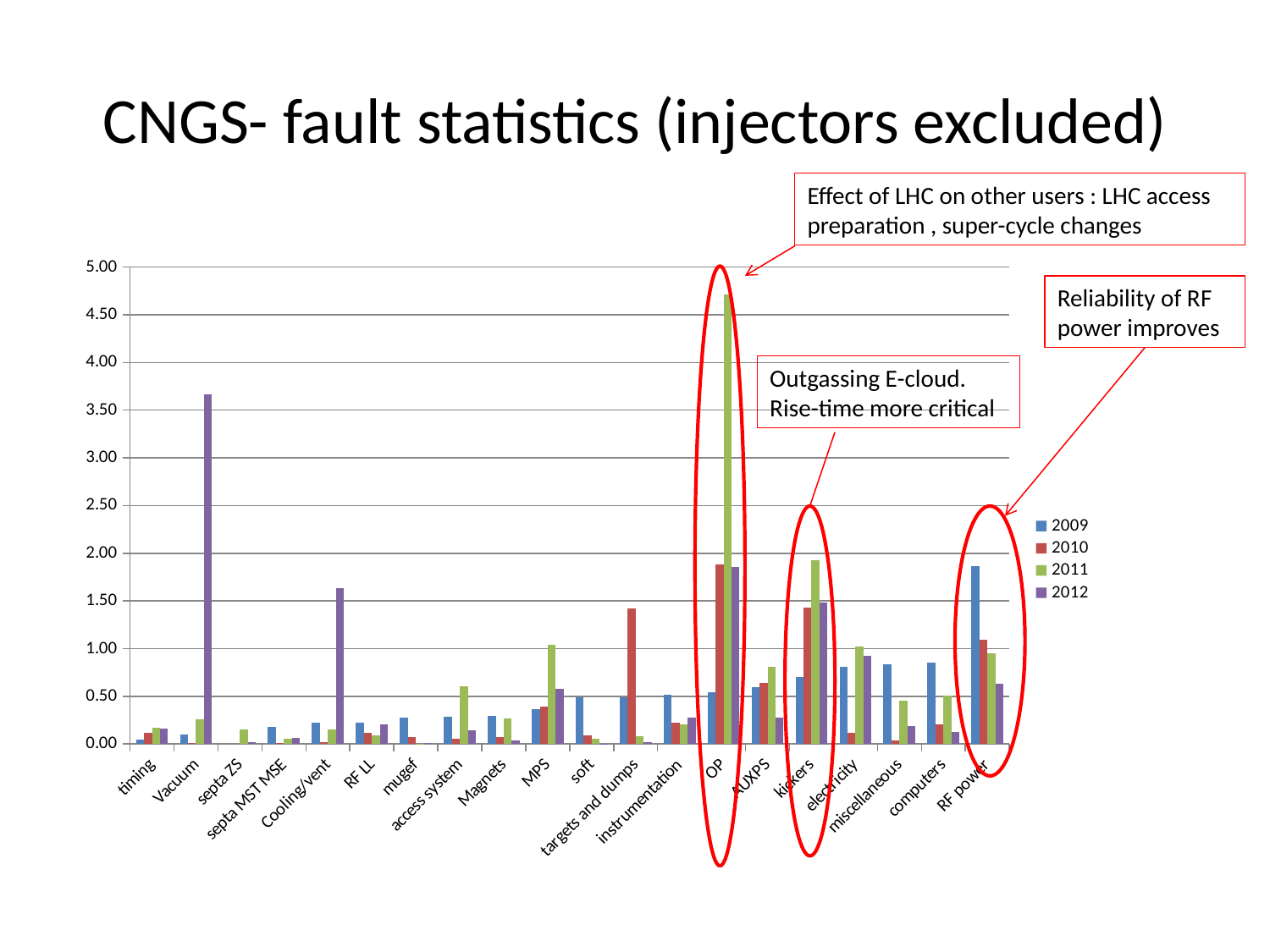
Which category has the highest 2012 value? Vacuum How many series does the legend list? 4 Which category has the highest 2009 value? RF power What kind of chart is shown on the slide? bar chart Which category has the highest 2011 value? OP Which series is shown in green in the legend? 2011 Is the 2011 value for OP greater or less than 4.00? greater How many categories are shown along the x axis? 20 For RF power, which is larger: the 2009 value or the 2012 value? 2009 Is the 2011 value for kickers greater or less than 1.50? greater Is the 2012 value for Vacuum greater or less than 3.00? greater